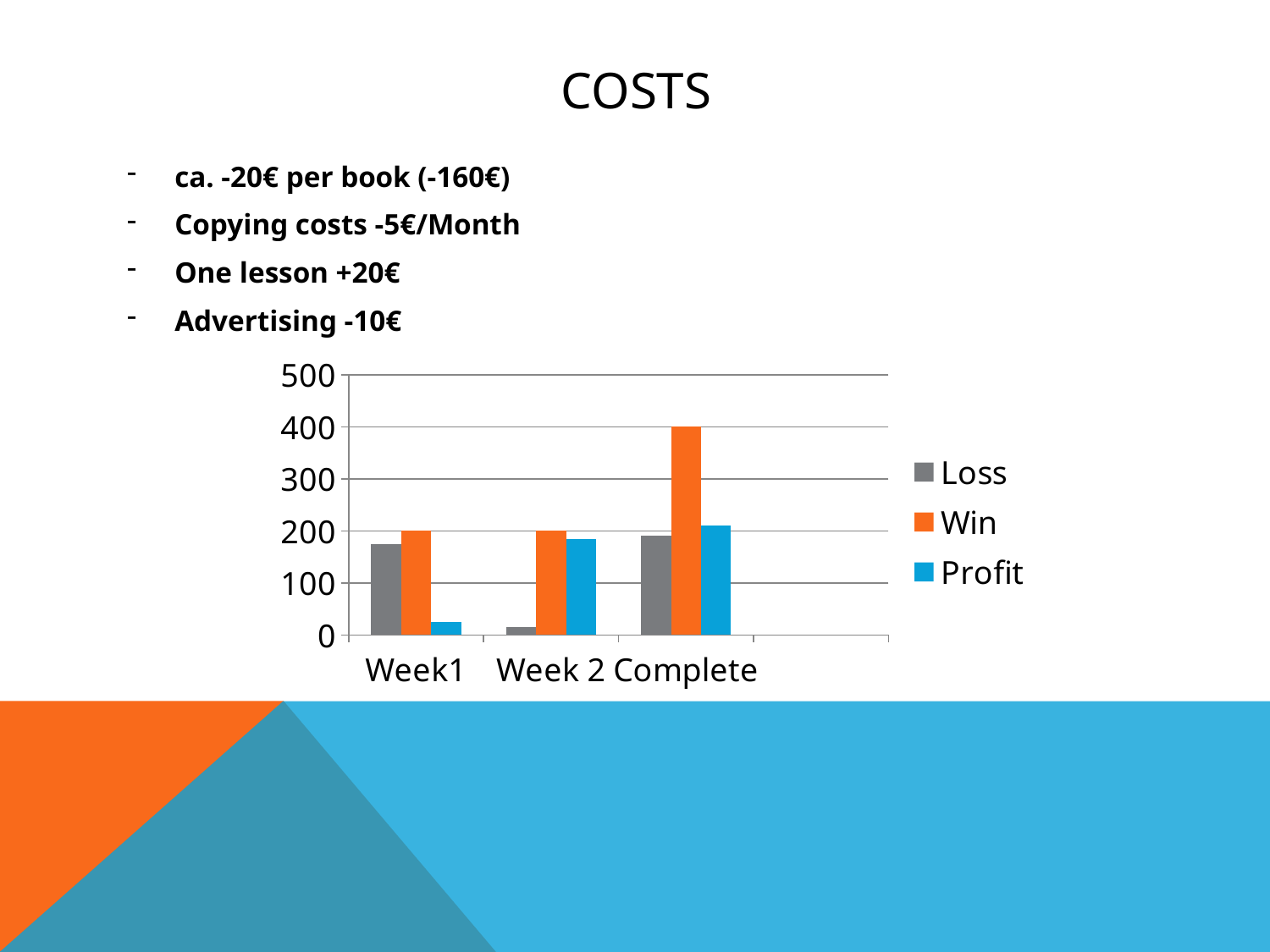
Which category has the lowest Profit value? Week1 Which category has the lowest Loss value? Week 2 How many categories are shown on the x axis of the chart? 3 What is the difference between the Win value for Complete and the Win value for Week1? 200 How many series does the chart legend list? 3 What is the Win value for Complete? 400 Is the Profit value for Week 2 greater or less than 100? greater What is the Win value for Week1? 200 For Week1, which is larger: the Loss value or the Profit value? Loss Is the Profit value for Week1 greater or less than 100? less What kind of chart is shown on the slide? bar chart Which category has the highest Win value? Complete